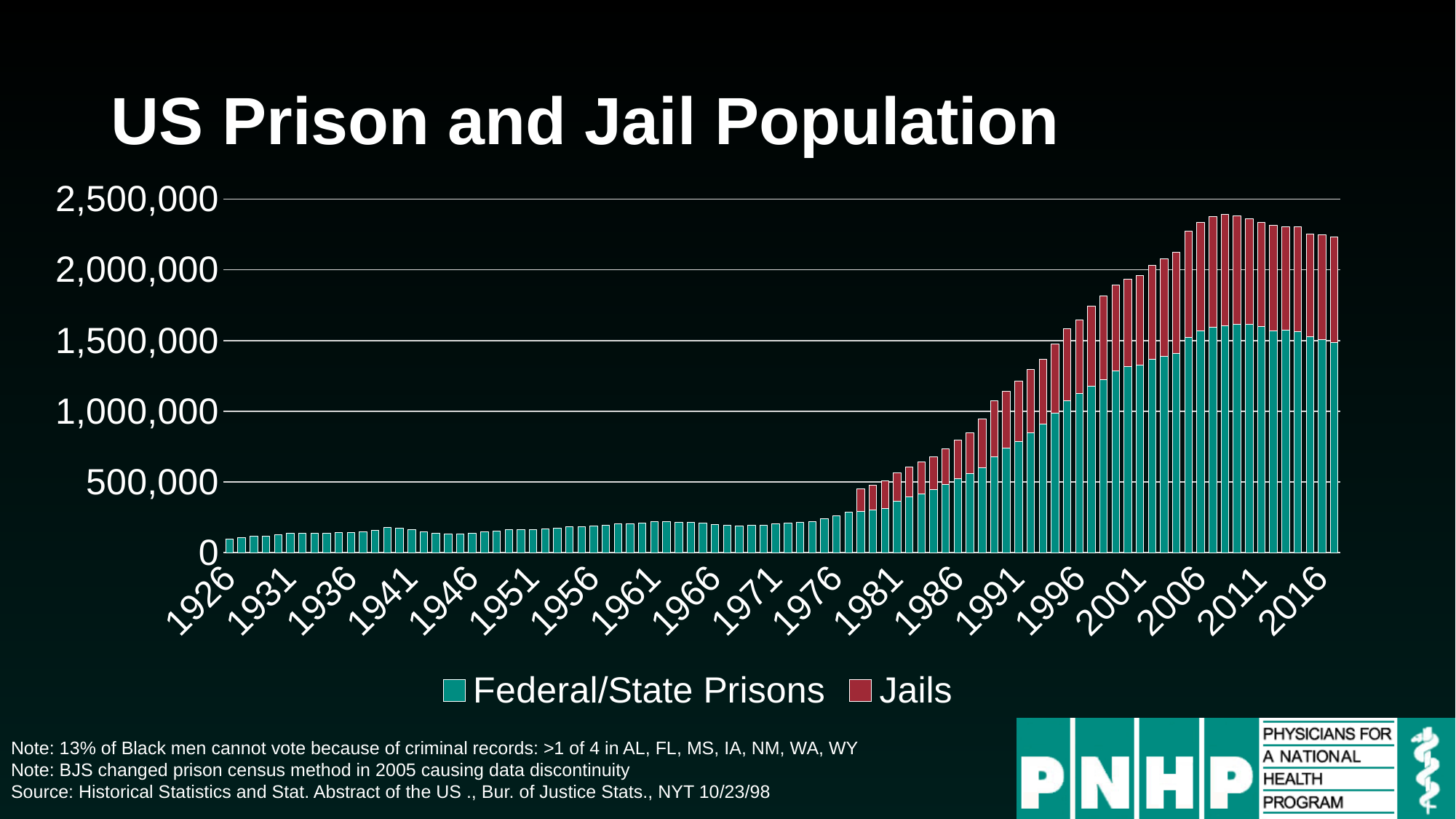
Which series is shown in red in the legend? Jails Is the total prison and jail population for 1976 greater or less than 500,000? less Is the Federal/State Prisons value for 1991 greater or less than 1,000,000? less How many series does the legend list? 2 Between 1976 and 2006, does the total prison and jail population rise or fall? rise Which year has the larger total prison and jail population, 1986 or 2006? 2006 Is the total prison and jail population for 1986 greater or less than 1,000,000? less In 2016, which series is larger, Federal/State Prisons or Jails? Federal/State Prisons What is the title of the chart? US Prison and Jail Population What kind of chart is shown on the slide? Stacked bar chart